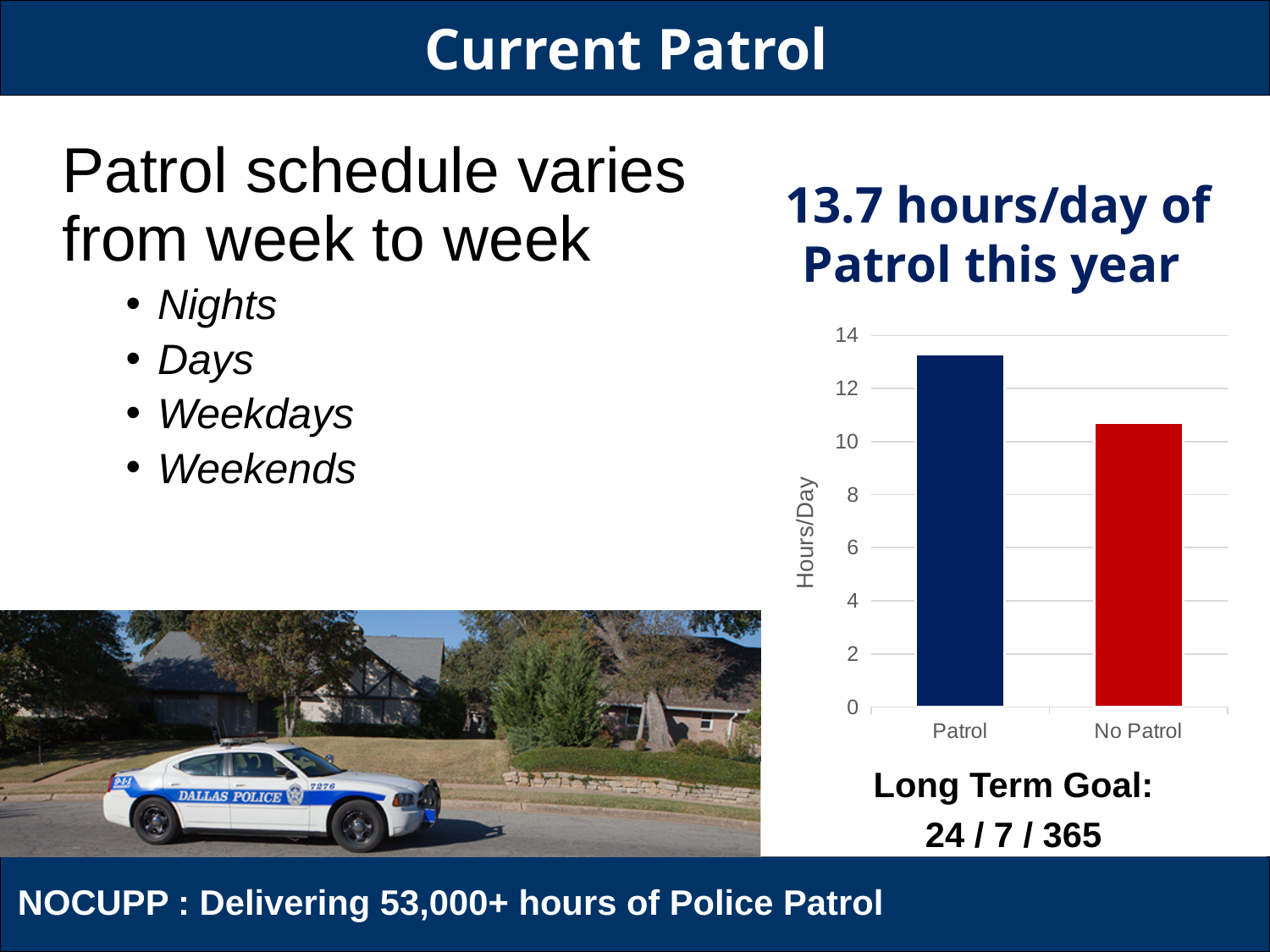
Is the value for No Patrol greater or less than 12? less What is the label of the vertical axis of the chart? Hours/Day What colour is the No Patrol bar in the chart? red Is the value for Patrol greater or less than 14? less Is the value for Patrol greater or less than 12? greater Which category has the highest value in the chart? Patrol What kind of chart is shown on the slide? bar chart Which category has the lowest value in the chart? No Patrol Which is larger, the value for Patrol or the value for No Patrol? Patrol How many bars does the chart show? 2